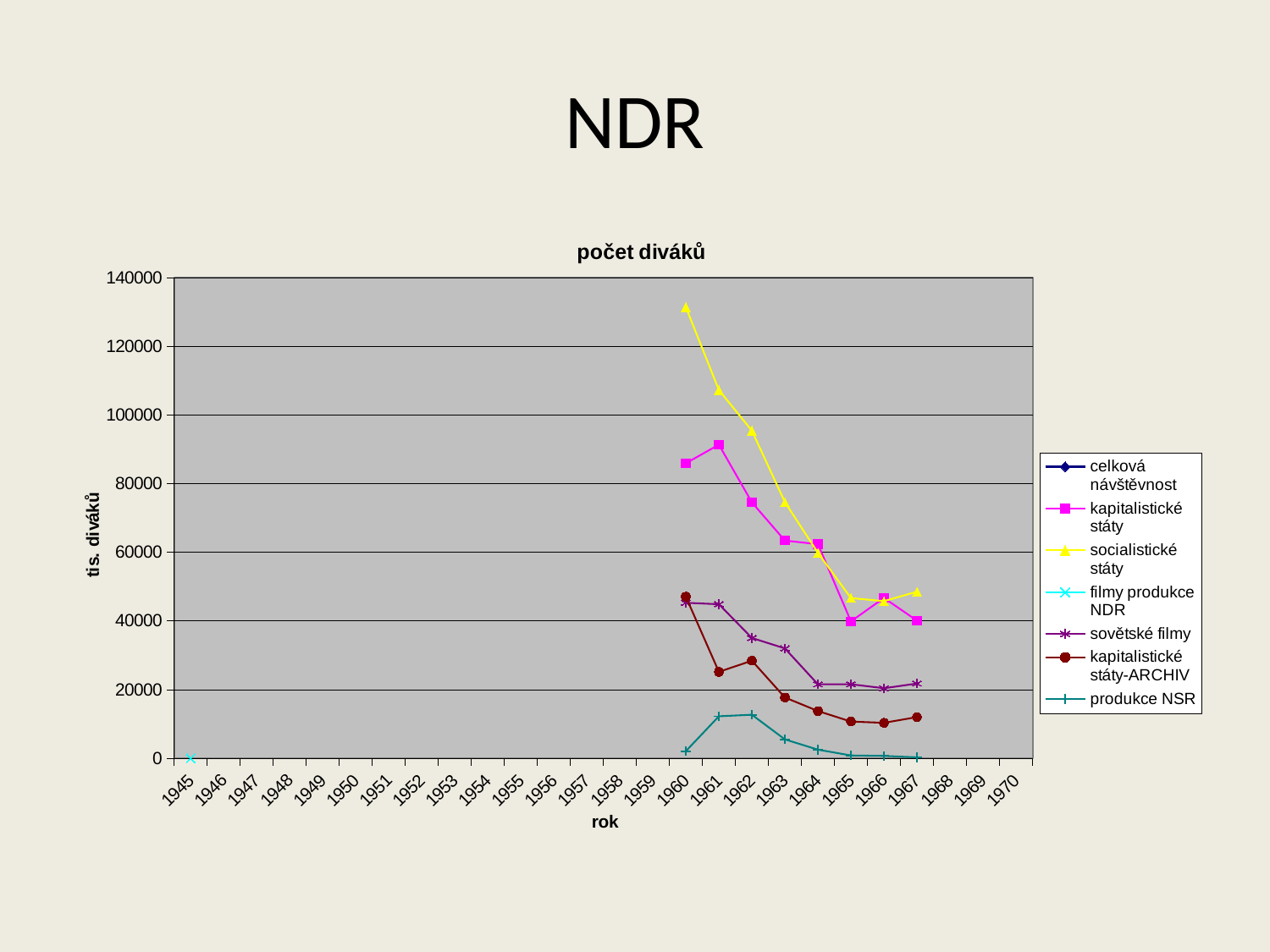
What kind of chart is shown on the slide? line chart Is the value for sovětské filmy in 1961 greater or less than 40000? greater How many years are labelled on the horizontal axis of the chart? 26 In 1967, which is larger: sovětské filmy or kapitalistické státy-ARCHIV? sovětské filmy What is the label of the vertical axis of the chart? tis. diváků Is the value for socialistické státy in 1960 greater or less than 120000? greater Do the values for socialistické státy rise or fall between 1960 and 1965? fall Is the value for produkce NSR in 1967 greater or less than 20000? less What is the title of the chart? počet diváků How many series does the legend of the chart list? 7 Which series has the highest value in 1960? socialistické státy